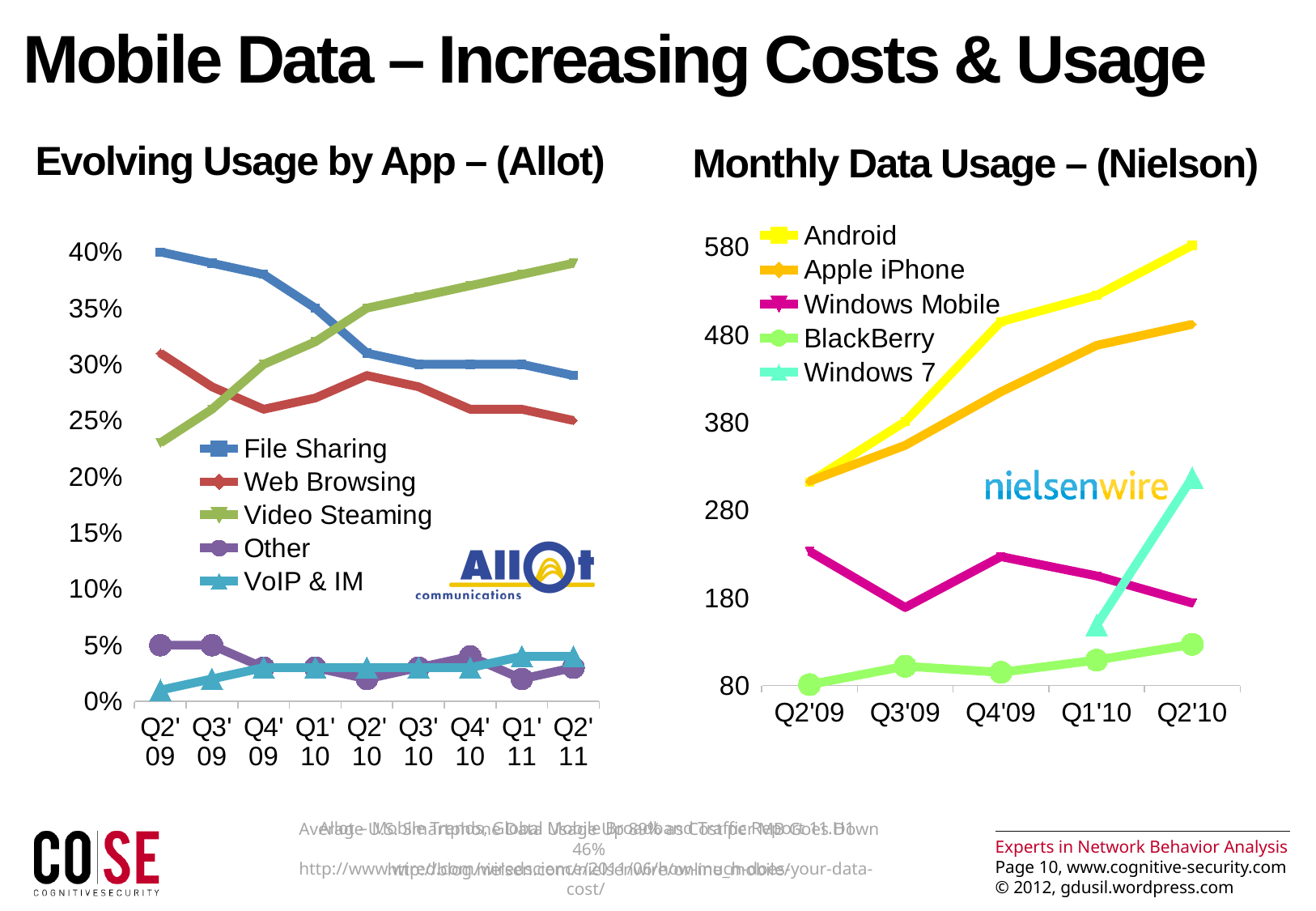
In the 'Monthly Data Usage – (Nielson)' chart, which is larger at Q1'10: Apple iPhone or Windows Mobile? Apple iPhone In the 'Evolving Usage by App – (Allot)' chart, is the Web Browsing value at Q2'11 greater or less than 30%? less How many series does the legend of the 'Monthly Data Usage – (Nielson)' chart list? 5 How many series does the legend of the 'Evolving Usage by App – (Allot)' chart list? 5 In the 'Monthly Data Usage – (Nielson)' chart, which series has the highest value at Q2'10? Android In the 'Monthly Data Usage – (Nielson)' chart, which series has the lowest value at Q2'09? BlackBerry What kind of chart is the 'Evolving Usage by App – (Allot)' chart? line chart In the 'Evolving Usage by App – (Allot)' chart, which series has the highest value at Q2'11? Video Steaming How many quarters are shown on the x axis of the 'Evolving Usage by App – (Allot)' chart? 9 In the 'Evolving Usage by App – (Allot)' chart, does the File Sharing series rise or fall from Q2'09 to Q2'11? fall In the 'Monthly Data Usage – (Nielson)' chart, is the Android value at Q2'10 greater or less than 480? greater In the 'Evolving Usage by App – (Allot)' chart, is the File Sharing value at Q2'09 greater or less than 35%? greater